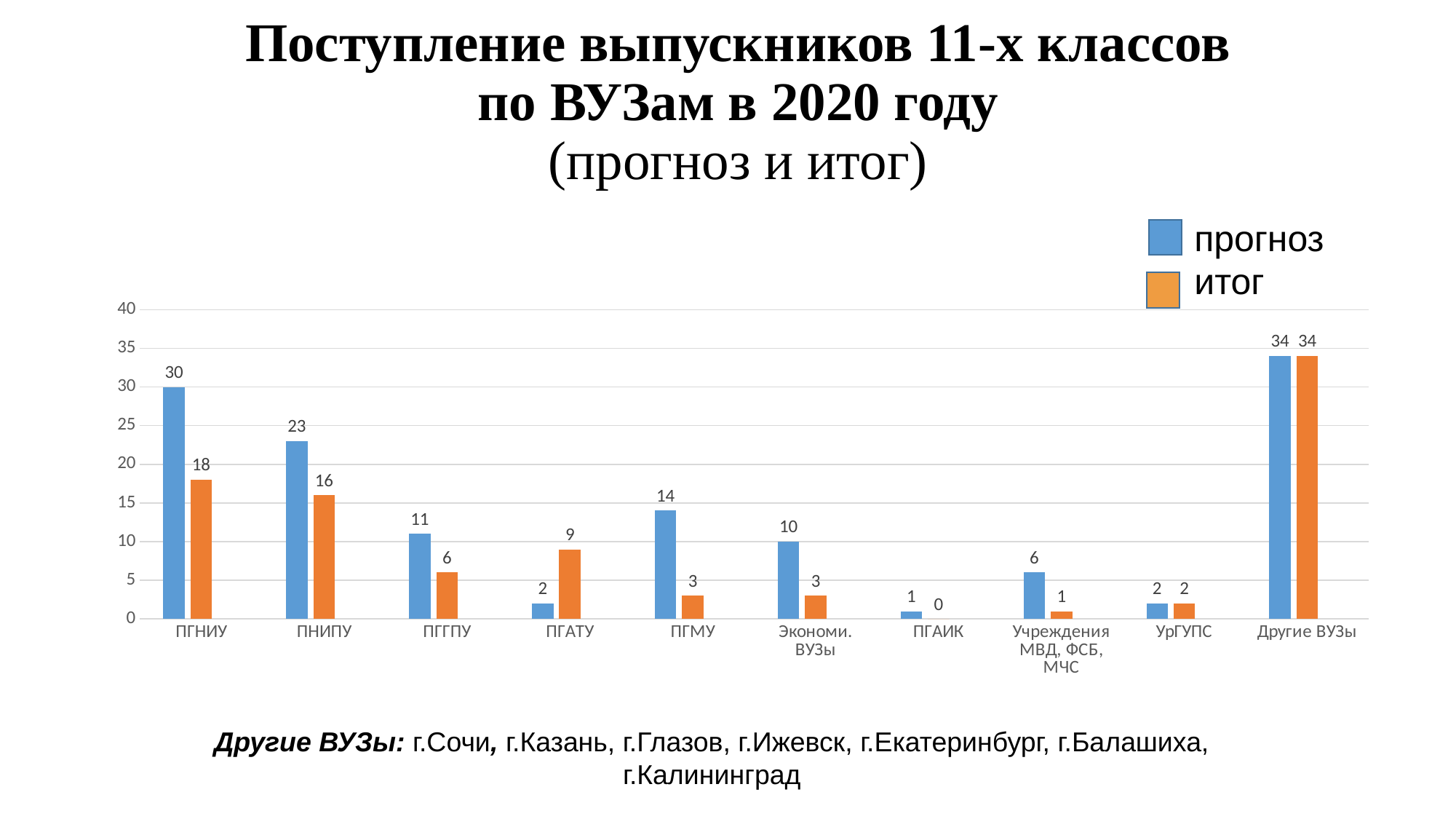
What is the прогноз value for ПГНИУ? 30 Is the прогноз value for ПНИПУ greater or less than 20? greater What colour represents the итог series? orange What is the итог value for ПНИПУ? 16 Which category has the highest прогноз value? Другие ВУЗы What kind of chart is shown on the slide? bar chart What is the difference between the прогноз and итог values for ПГНИУ? 12 What is the итог value for ПГАТУ? 9 Which is larger for ПГАТУ, the прогноз value or the итог value? итог How many series does the legend list? 2 Which category has the lowest итог value? ПГАИК How many categories are shown on the x axis? 10